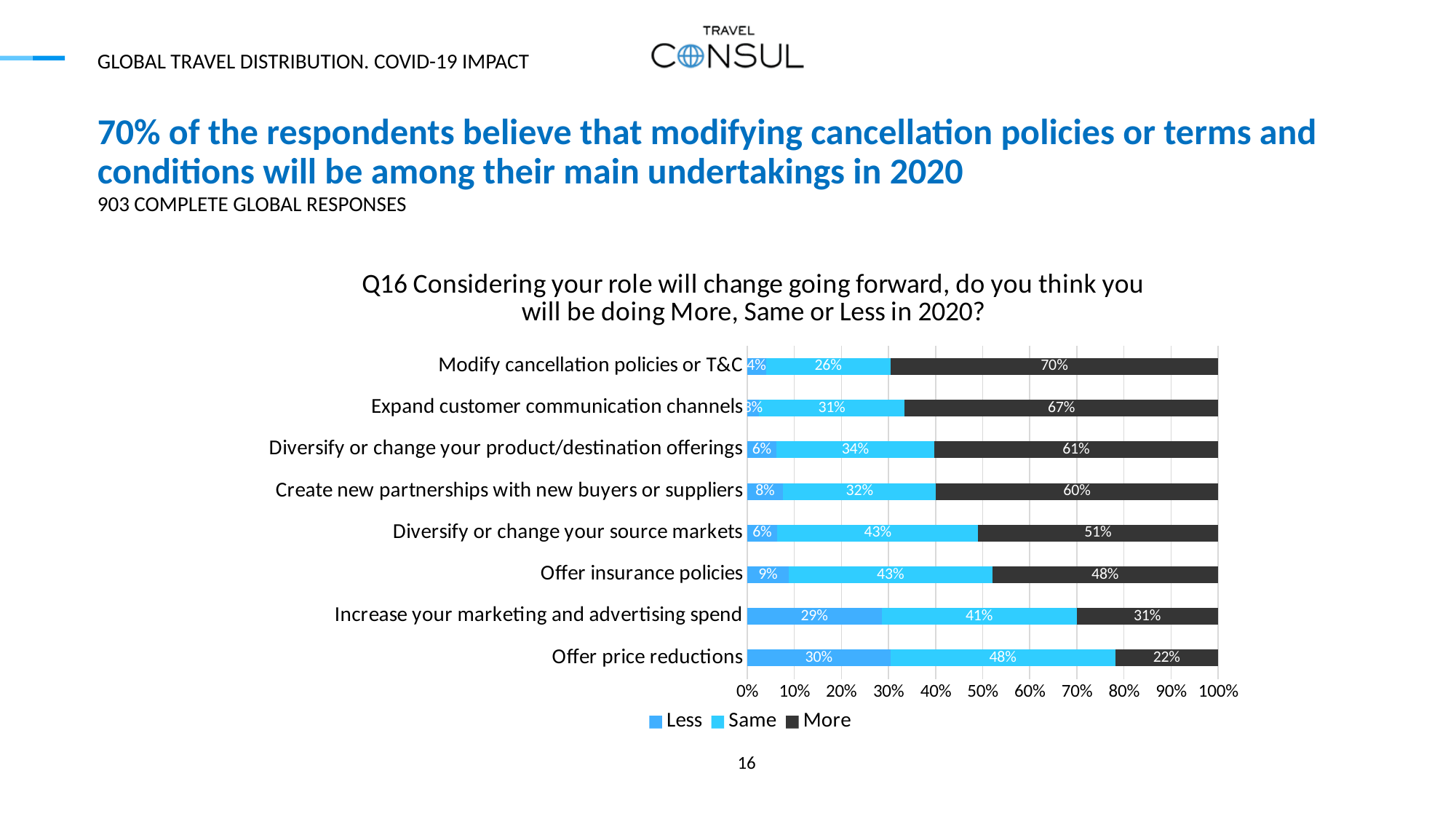
Is the More value for "Expand customer communication channels" greater or less than 50%? greater Which is larger: the Same value for "Diversify or change your source markets" or the Same value for "Create new partnerships with new buyers or suppliers"? Diversify or change your source markets How many categories are shown in the chart? 8 Which series is shown in dark grey/black in the chart? More What percentage of respondents said they will be doing More of "Modify cancellation policies or T&C"? 70% Which category has the highest More value? Modify cancellation policies or T&C What is the Same value for "Offer price reductions"? 48% What kind of chart is shown on the slide? Stacked bar chart Which category has the lowest More value? Offer price reductions What is the Less value for "Increase your marketing and advertising spend"? 29% How many series does the legend list? 3 What is the difference between the More values for "Offer insurance policies" and "Offer price reductions"? 26%